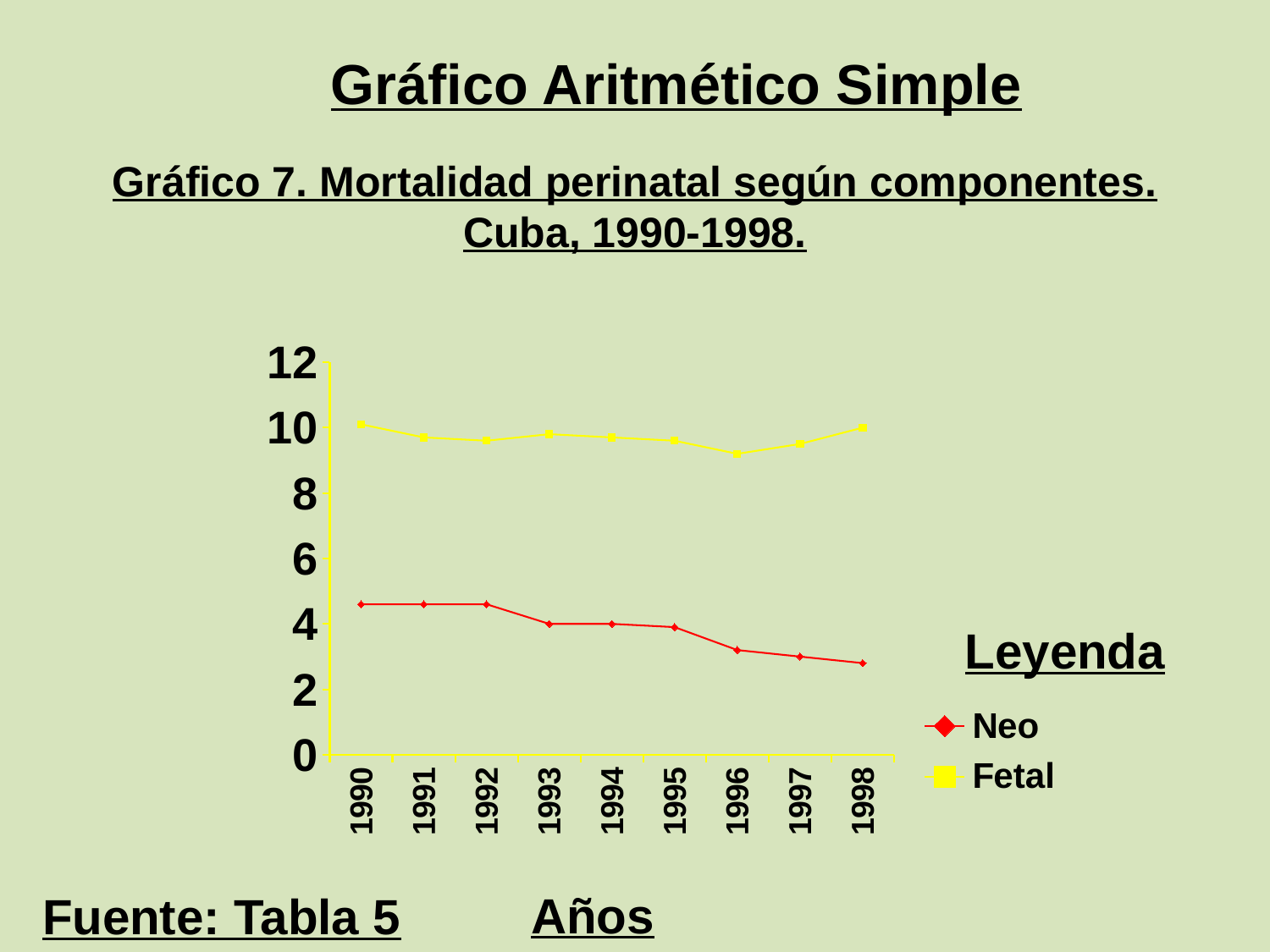
How many series does the legend list? 2 Is the value for Neo in 1990 greater or less than 4? greater Is the value for Fetal in 1996 greater or less than 10? less Which series is plotted in red? Neo Is the value for Neo in 1996 greater or less than 4? less How many years are plotted along the x axis? 9 Does the Neo series rise or fall from 1990 to 1998? fall In which year is the Fetal series at its lowest? 1996 What kind of chart is shown on the slide? line chart Which series has the larger value in 1994, Neo or Fetal? Fetal What is the title of the chart? Gráfico 7. Mortalidad perinatal según componentes. Cuba, 1990-1998.